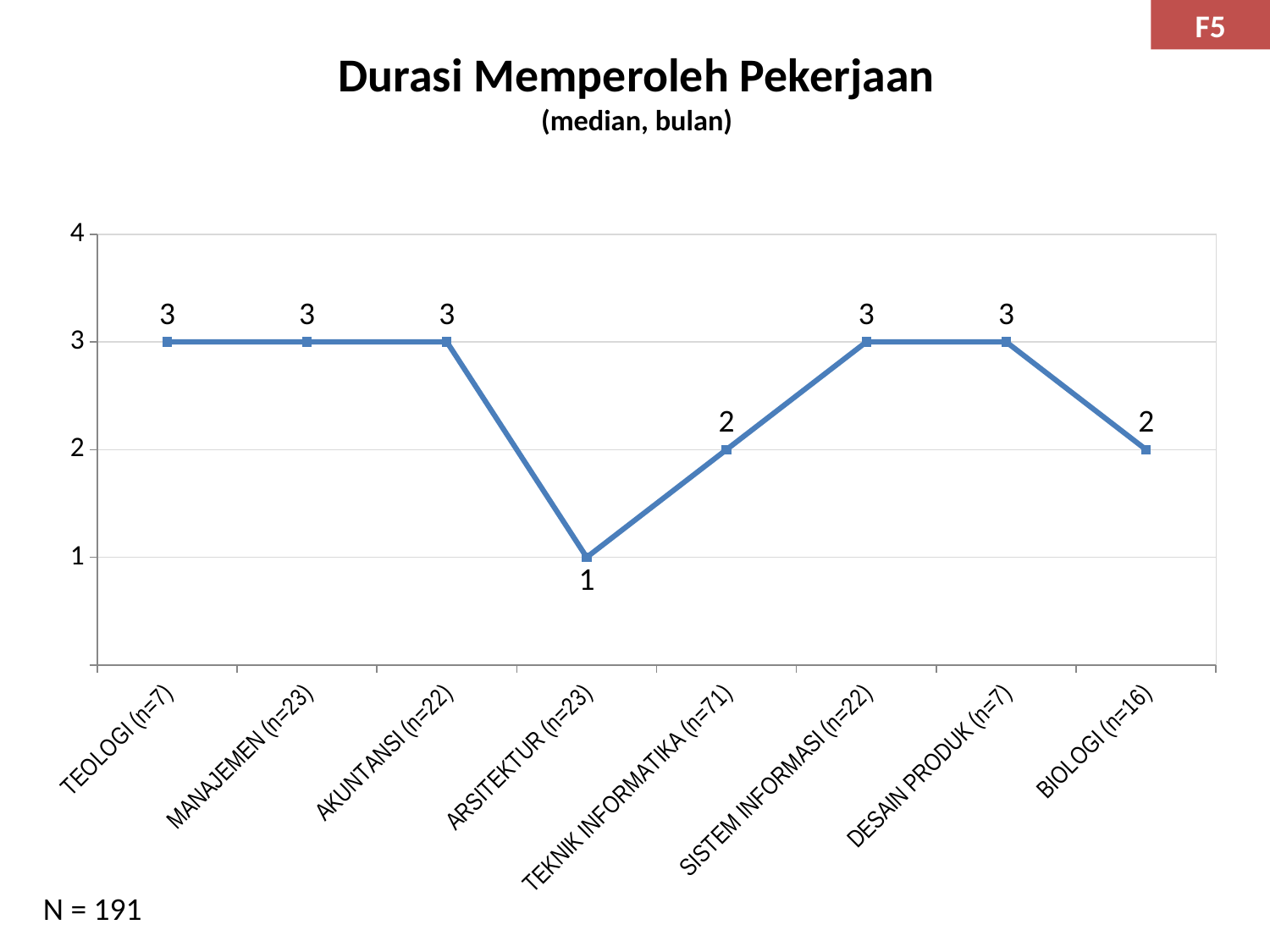
What kind of chart is shown on the slide? Line chart How many categories are plotted on the chart? 8 What is the median duration (in months) for BIOLOGI (n=16)? 2 What is the median duration (in months) for TEKNIK INFORMATIKA (n=71)? 2 What is the median duration (in months) for DESAIN PRODUK (n=7)? 3 What is the title of the chart? Durasi Memperoleh Pekerjaan What is the difference between the median duration for AKUNTANSI (n=22) and ARSITEKTUR (n=23)? 2 Does the value rise or fall from AKUNTANSI (n=22) to ARSITEKTUR (n=23)? Fall What is the median duration (in months) for ARSITEKTUR (n=23)? 1 Which category has the lowest median duration? ARSITEKTUR (n=23) Which has a larger median duration, BIOLOGI (n=16) or ARSITEKTUR (n=23)? BIOLOGI (n=16) Which has a larger median duration, SISTEM INFORMASI (n=22) or TEKNIK INFORMATIKA (n=71)? SISTEM INFORMASI (n=22)